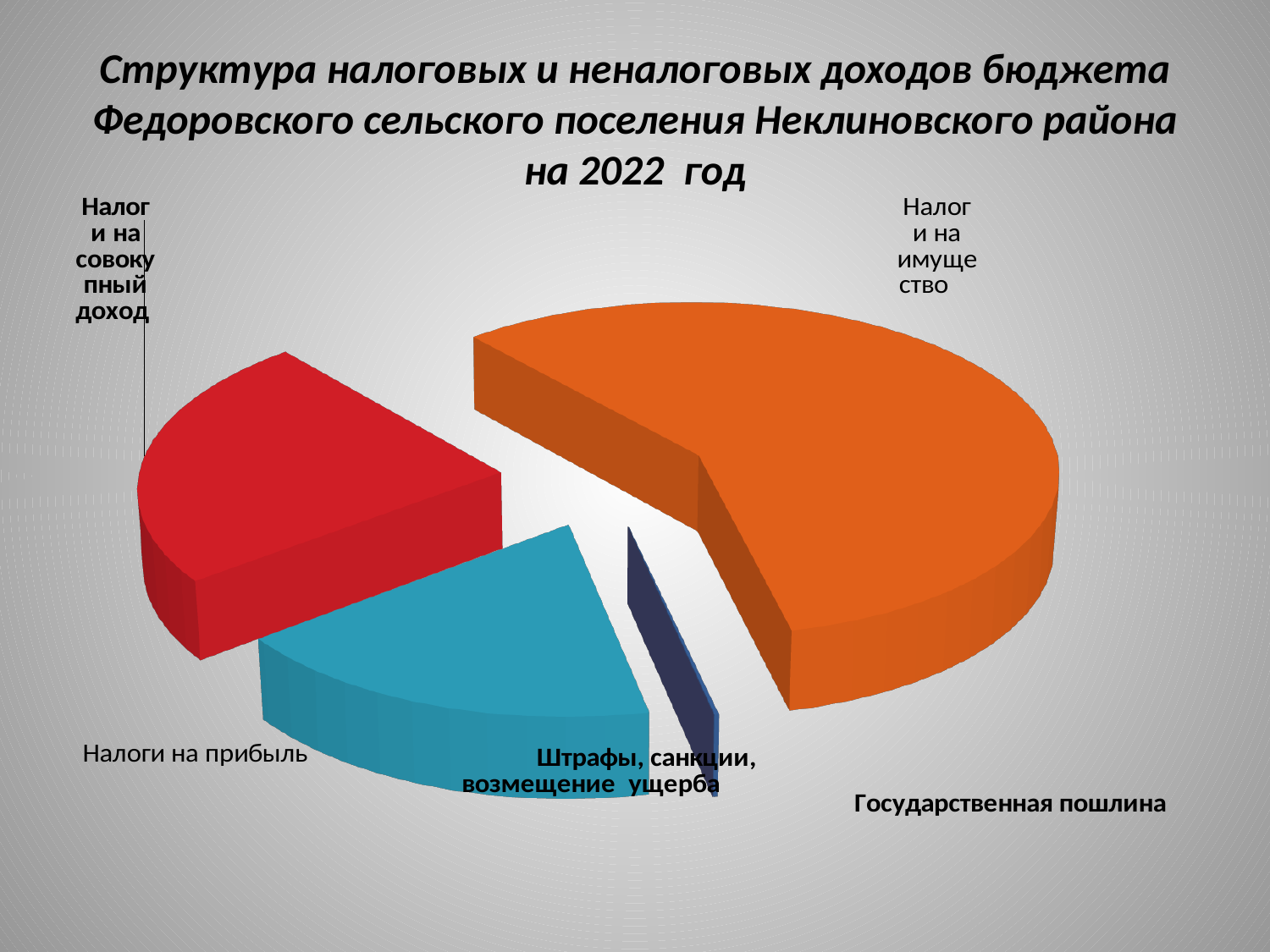
What year does the chart title refer to? 2022 Which is larger: the slice for Налоги на совокупный доход or the slice for Штрафы, санкции, возмещение ущерба? Налоги на совокупный доход Which is larger: the slice for Налоги на имущество or the slice for Налоги на прибыль? Налоги на имущество What kind of chart is shown on the slide? Pie chart Which category has the largest slice of the pie? Налоги на имущество What colour is the slice for Налоги на имущество? Orange Which is larger: the slice for Налоги на прибыль or the slice for Штрафы, санкции, возмещение ущерба? Налоги на прибыль How many categories are labelled on the pie chart? 5